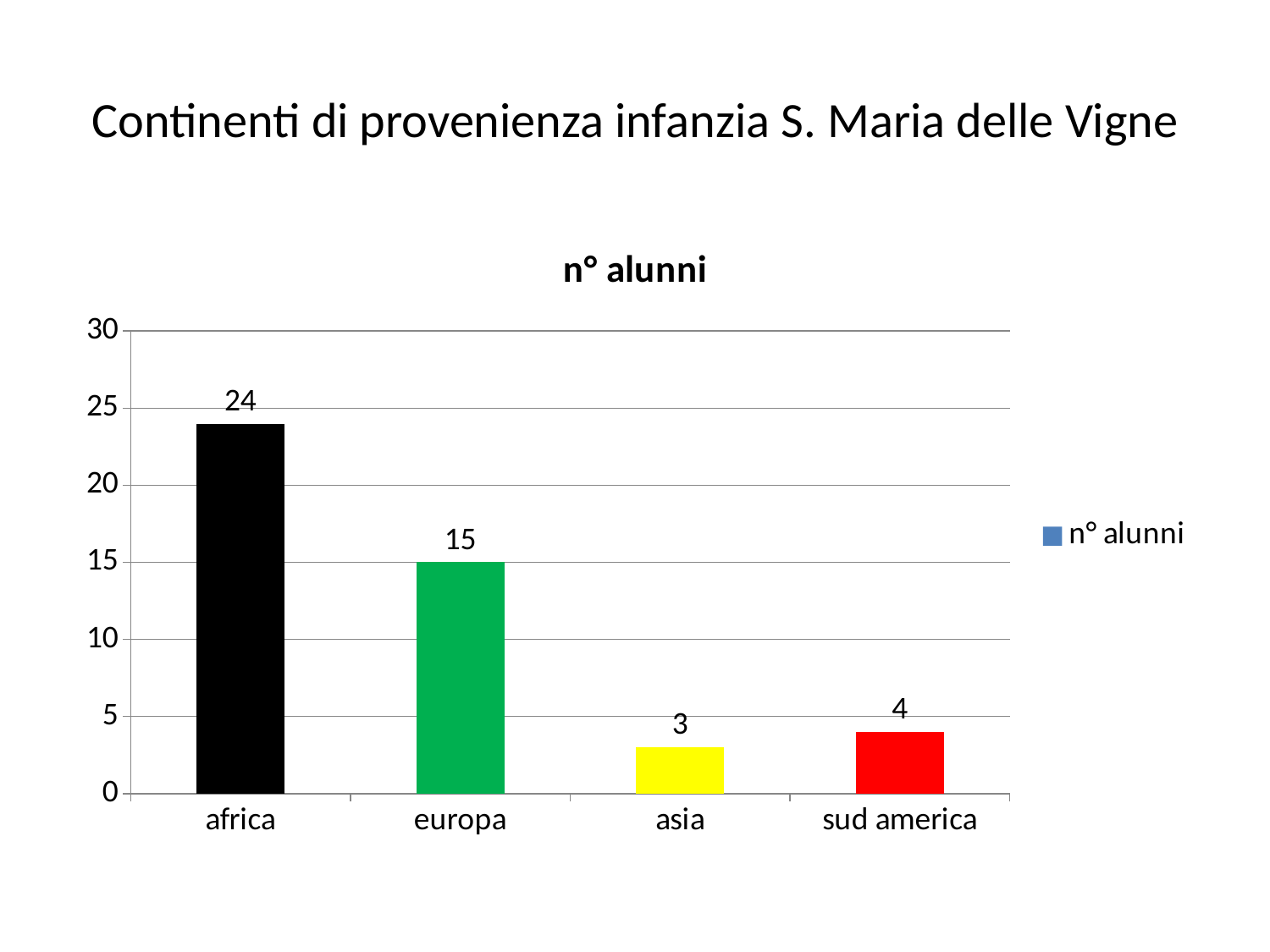
What is the value for africa? 24 What is the difference between the values for africa and europa? 9 What kind of chart is shown on the slide? bar chart What is the value for asia? 3 Is the value for europa greater or less than 20? less Which category has the lowest value? asia What is the value for sud america? 4 Which category has the highest value? africa What is the title of the chart? n° alunni How many categories are shown on the x axis? 4 What is the value for europa? 15 Which is larger, the value for sud america or the value for asia? sud america